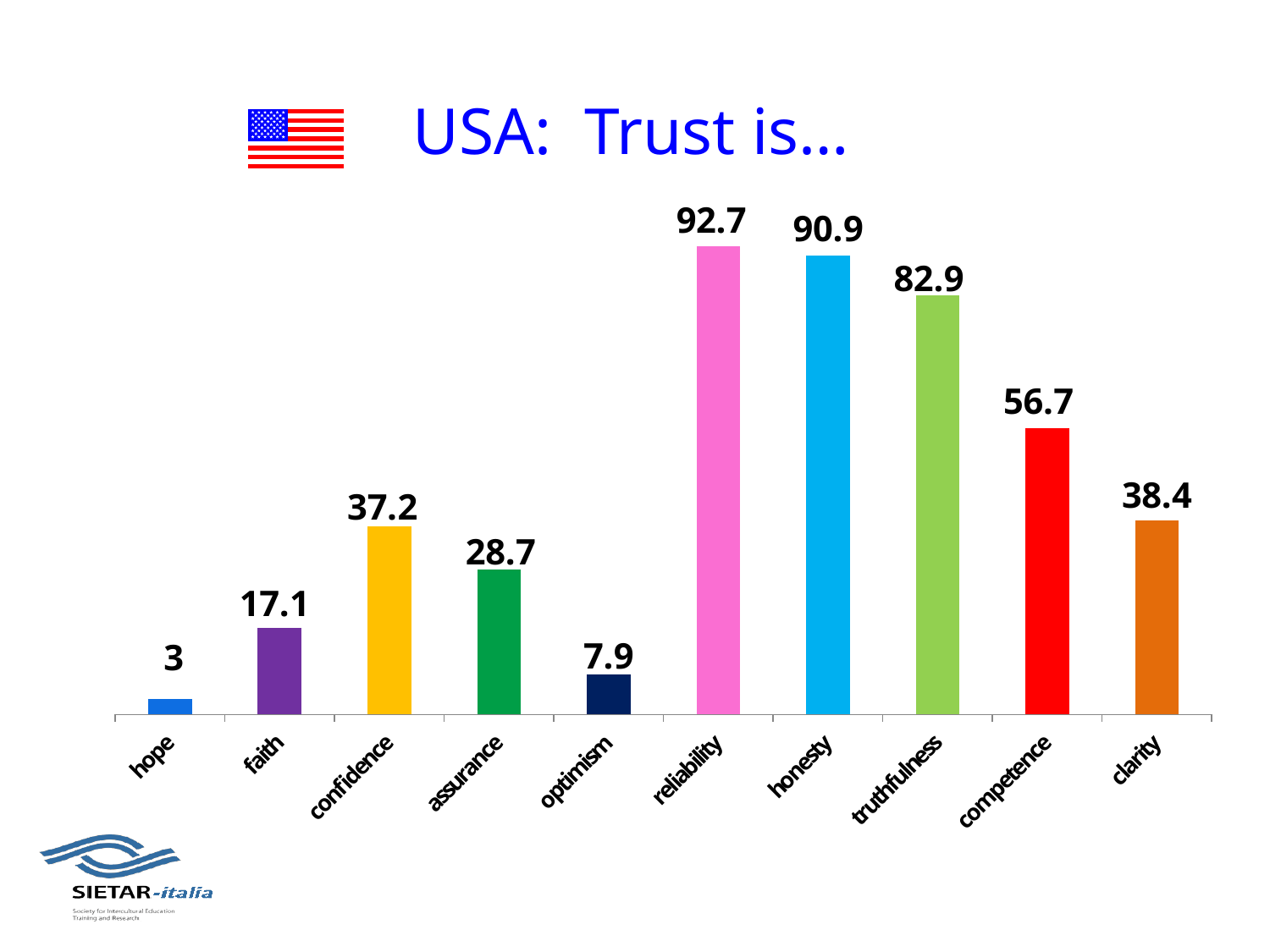
Which is larger, the value for clarity or the value for confidence? clarity What is the value for optimism? 7.9 What kind of chart is shown on the slide? bar chart What is the value for competence? 56.7 What is the title of the slide? USA: Trust is... Which category has the lowest value? hope Which category has the highest value? reliability What is the difference between the values for honesty and truthfulness? 8 What is the difference between the values for confidence and assurance? 8.5 What is the value for reliability? 92.7 What is the value for hope? 3 How many categories are shown on the x axis? 10